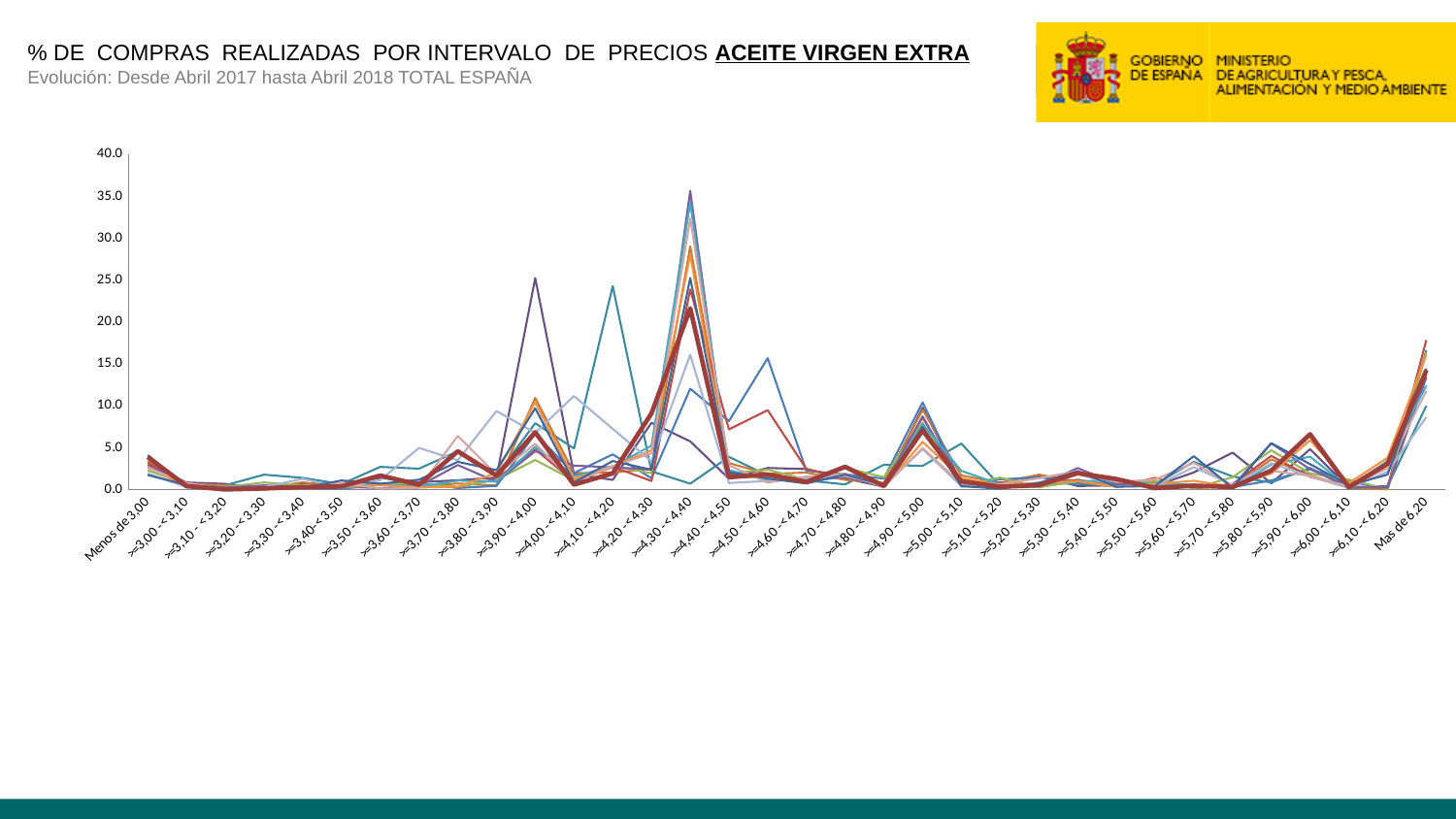
What is the last category label on the x axis? Mas de 6,20 What kind of chart is shown on the slide? line chart How many price intervals (categories) are shown along the x axis? 34 Which is larger: the highest value at >=4,40 - <4,50 or the highest value at >=4,90 - <5,00? >=4,90 -< 5,00 At which price interval does the highest peak of any line occur? >=4,30 -< 4,40 Are all the values at the >=3,00 - <3,10 interval greater or less than 5? less Is the highest value reached at the >=4,00 - <4,10 interval greater or less than 20? less What is the first category label on the x axis? Menos de 3,00 Is the highest value reached at the >=4,20 - <4,30 interval greater or less than 20? less